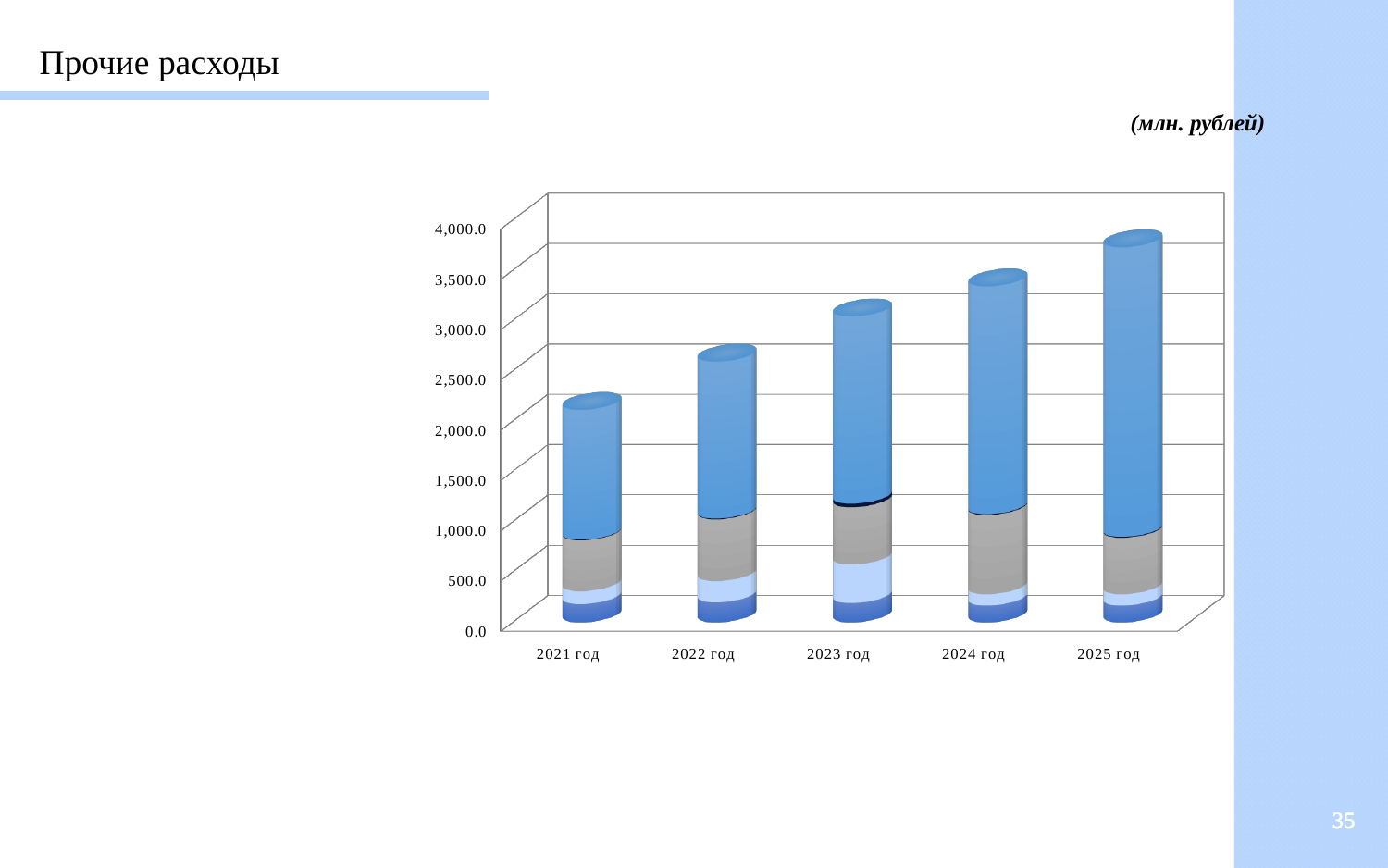
Which year has the tallest bar in the chart? 2025 год How many years are shown on the x axis of the chart? 5 Is the total bar for 2024 год greater or less than 3,000? greater Is the total bar for 2025 год greater or less than 3,500? greater Which bar is taller, 2024 год or 2022 год? 2024 год In what units are the chart values given, according to the slide? млн. рублей Which year has the shortest bar in the chart? 2021 год Is the total bar for 2022 год greater or less than 3,000? less Do the bar totals rise or fall from 2021 год to 2025 год? rise What kind of chart is shown on the slide? bar chart What is the title of the slide containing the chart? Прочие расходы